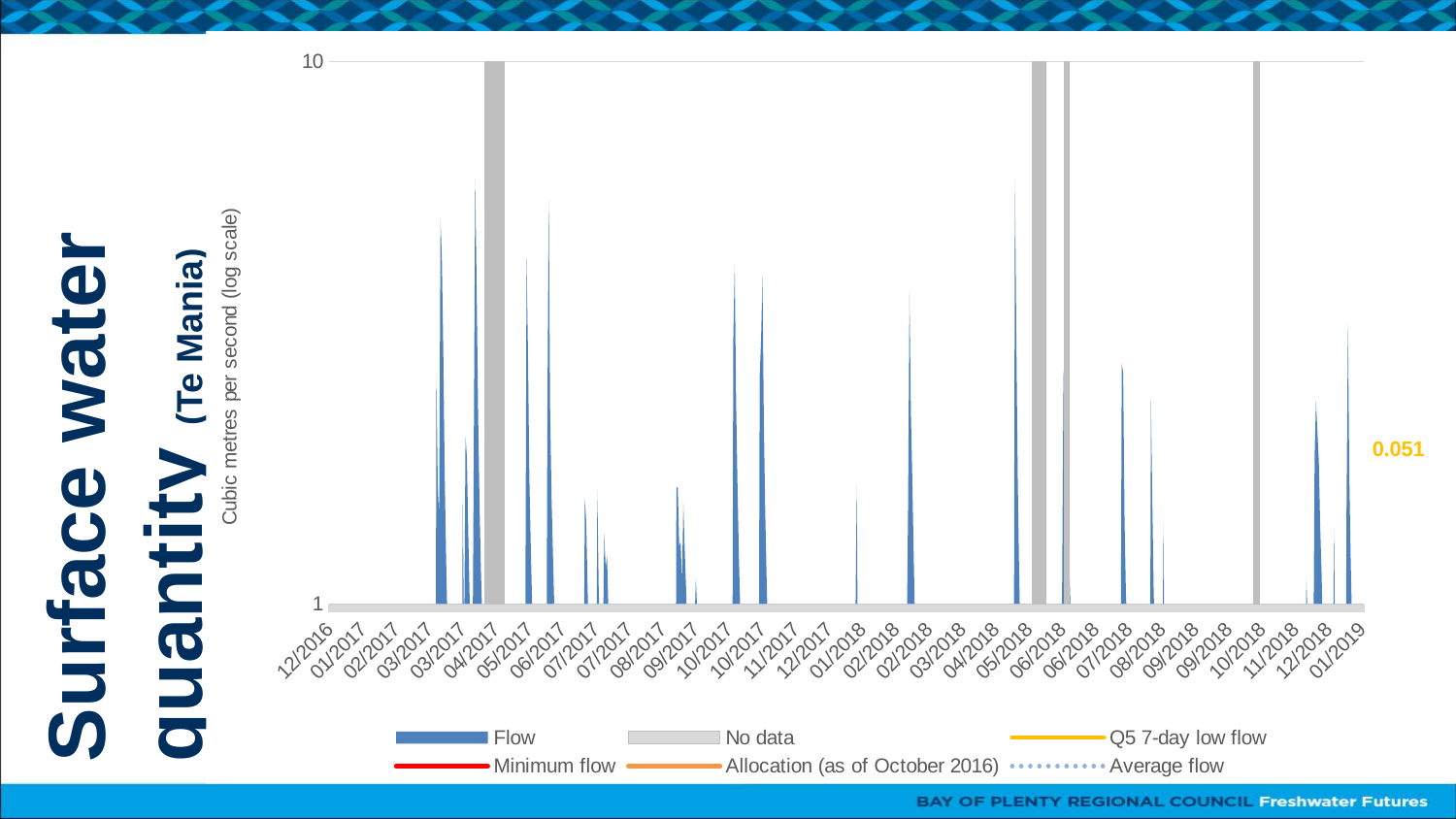
What is the lowest tick value shown on the y axis? 1 Is the highest flow peak shown on the chart greater or less than 10? less What is the y-axis label of the chart? Cubic metres per second (log scale) What is the highest tick value shown on the y axis? 10 Which legend entry is shown in grey? No data What is the first date label on the x axis of the chart? 12/2016 How many series does the chart legend list? 6 What kind of chart is shown on the slide? bar chart What is the last date label on the x axis of the chart? 01/2019 What value is printed as a data label on the right-hand side of the chart? 0.051